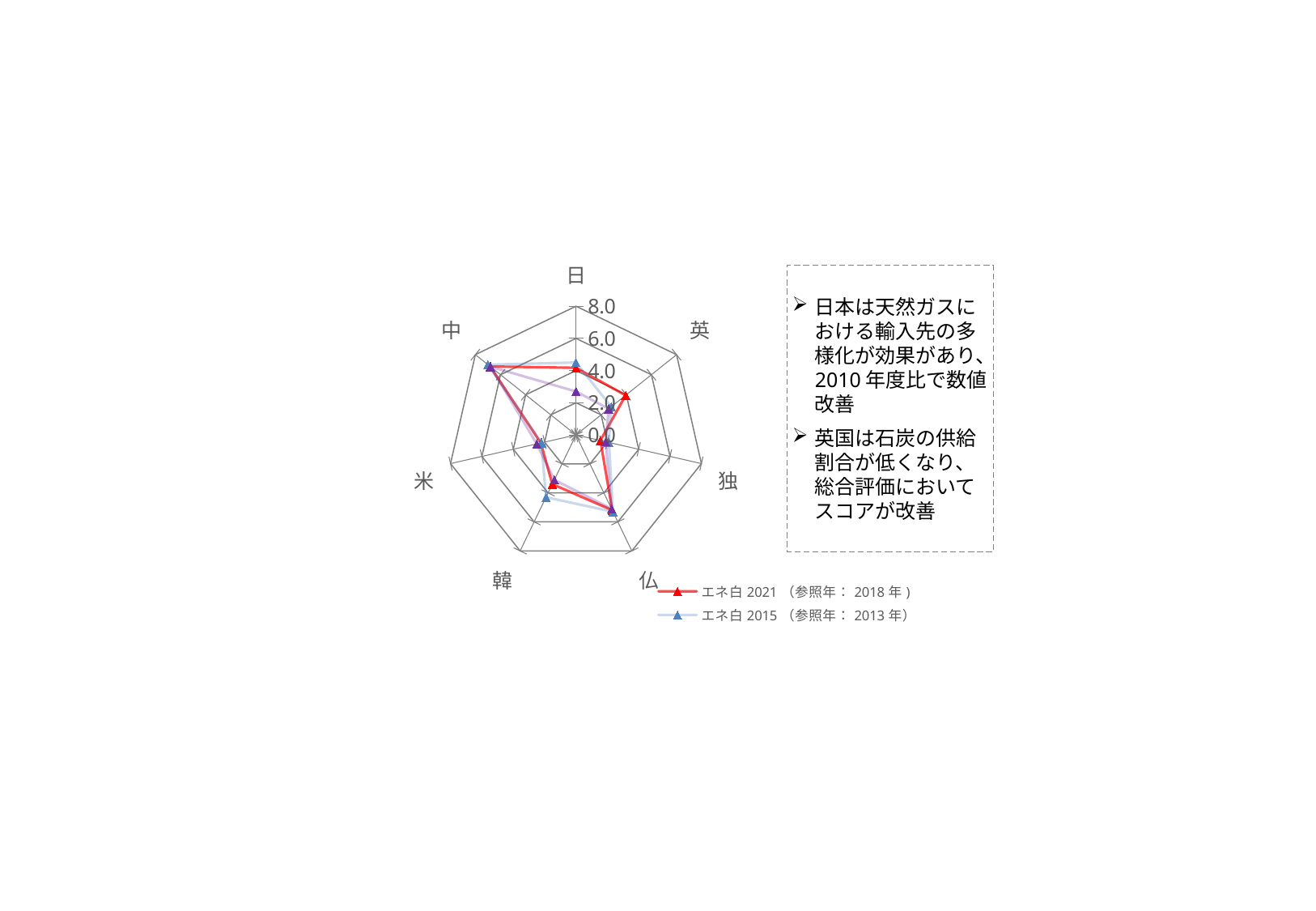
Which series is drawn in red according to the legend? エネ白2021（参照年：2018年） For the エネ白2021 series, is the value for 米 greater or less than 4.0? less What kind of chart is shown on the slide? radar chart For the エネ白2021 series, is the value for 仏 greater or less than 4.0? greater For the エネ白2021 series, which country has the highest value? 中 For the エネ白2021 series, is the value for 中 greater or less than 6.0? greater How many series does the legend list? 2 For the エネ白2021 series, which is larger, the value for 中 or the value for 米? 中 For the エネ白2021 series, which is larger, the value for 仏 or the value for 日? 仏 What is the maximum value shown on the radar chart's axis scale? 8.0 How many categories (countries) are plotted on the radar chart? 7